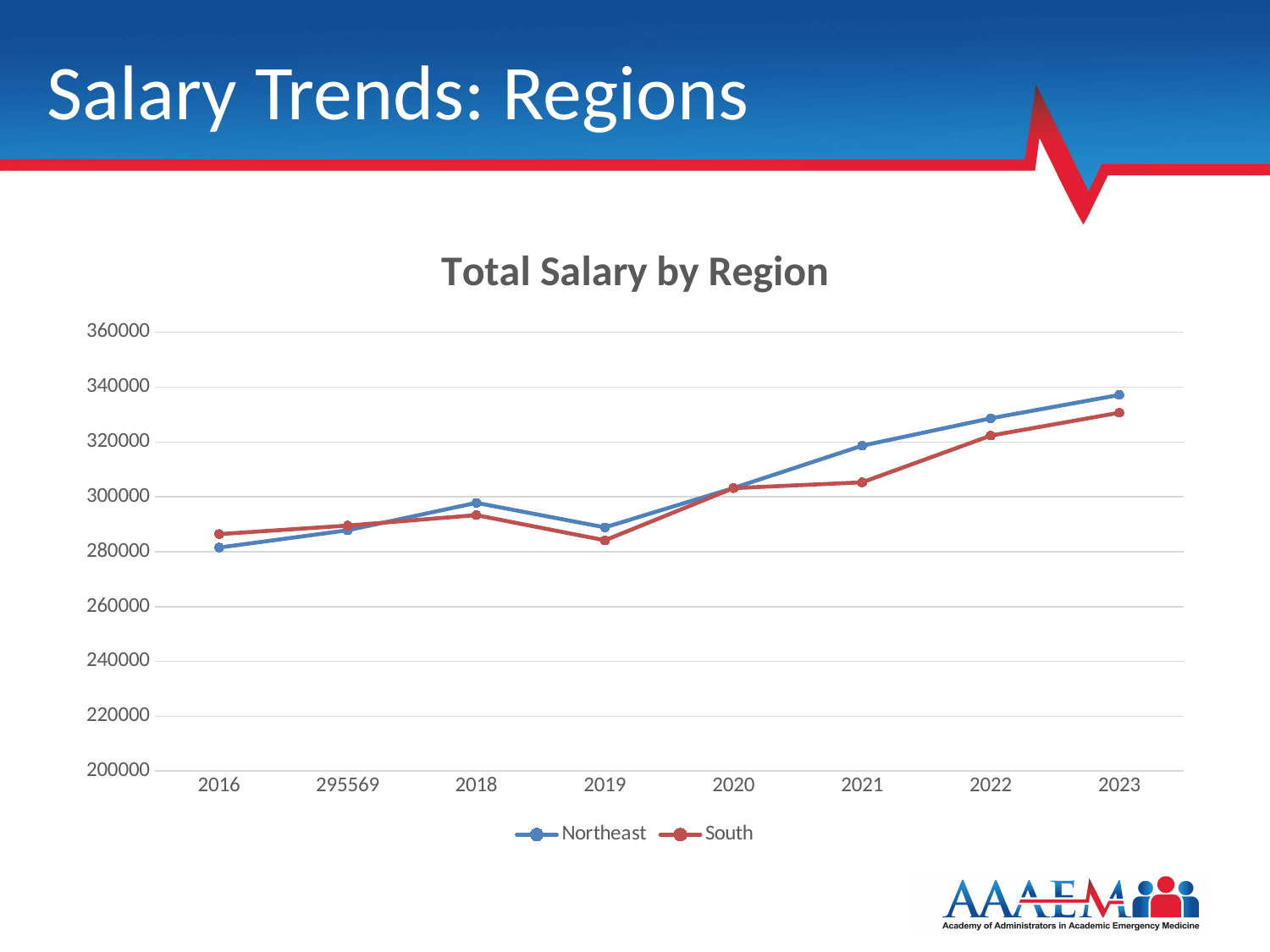
How many points are plotted along the x axis for each series? 8 In 2016, which series has the higher value, Northeast or South? South Is the value for Northeast in 2023 greater or less than 320000? greater Which series is drawn in red? South Is the value for Northeast in 2022 greater or less than 320000? greater In which year does the Northeast series reach its highest value? 2023 How many series does the legend list? 2 In 2021, which series has the higher value, Northeast or South? Northeast Is the value for South in 2019 greater or less than 300000? less Overall, do the values for South rise or fall from 2016 to 2023? Rise What is the title of the chart? Total Salary by Region What kind of chart is shown on the slide? Line chart